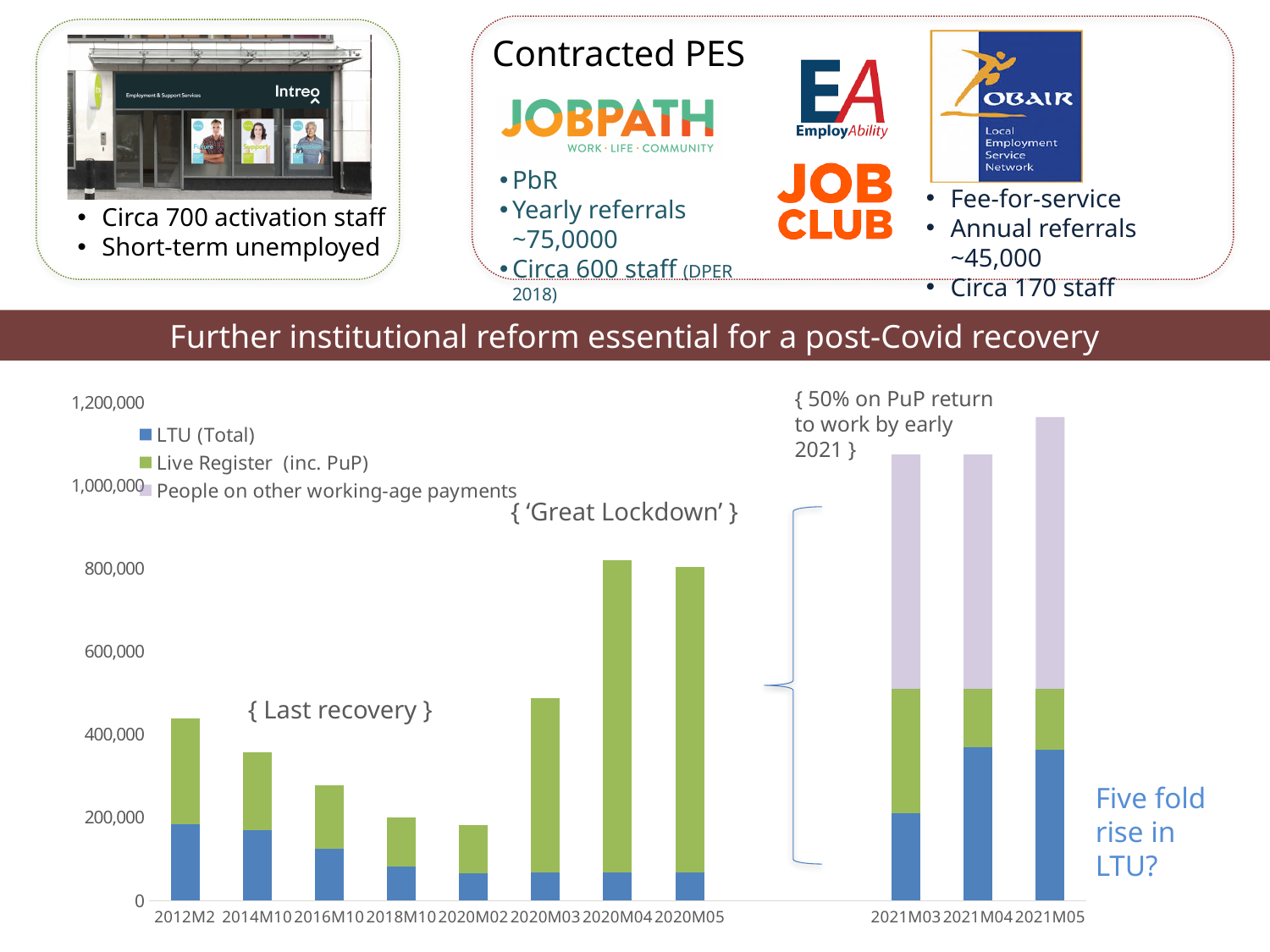
Which colour represents the LTU (Total) series in the chart legend? Blue Do the stacked bar totals rise or fall from 2012M2 to 2020M02? Fall How many series does the chart legend list? 3 Is the total for 2016M10 greater or less than 400,000? less Which legend series appears only in the 2021 bars of the chart? People on other working-age payments Is the total for 2020M03 greater or less than 600,000? less Which has the larger total bar, 2012M2 or 2014M10? 2012M2 Is the total for 2021M03 greater or less than 1,000,000? greater Which category has the tallest stacked bar in the chart? 2021M05 What kind of chart is shown on the slide? Stacked bar chart How many categories (bars) are shown along the x axis of the chart? 11